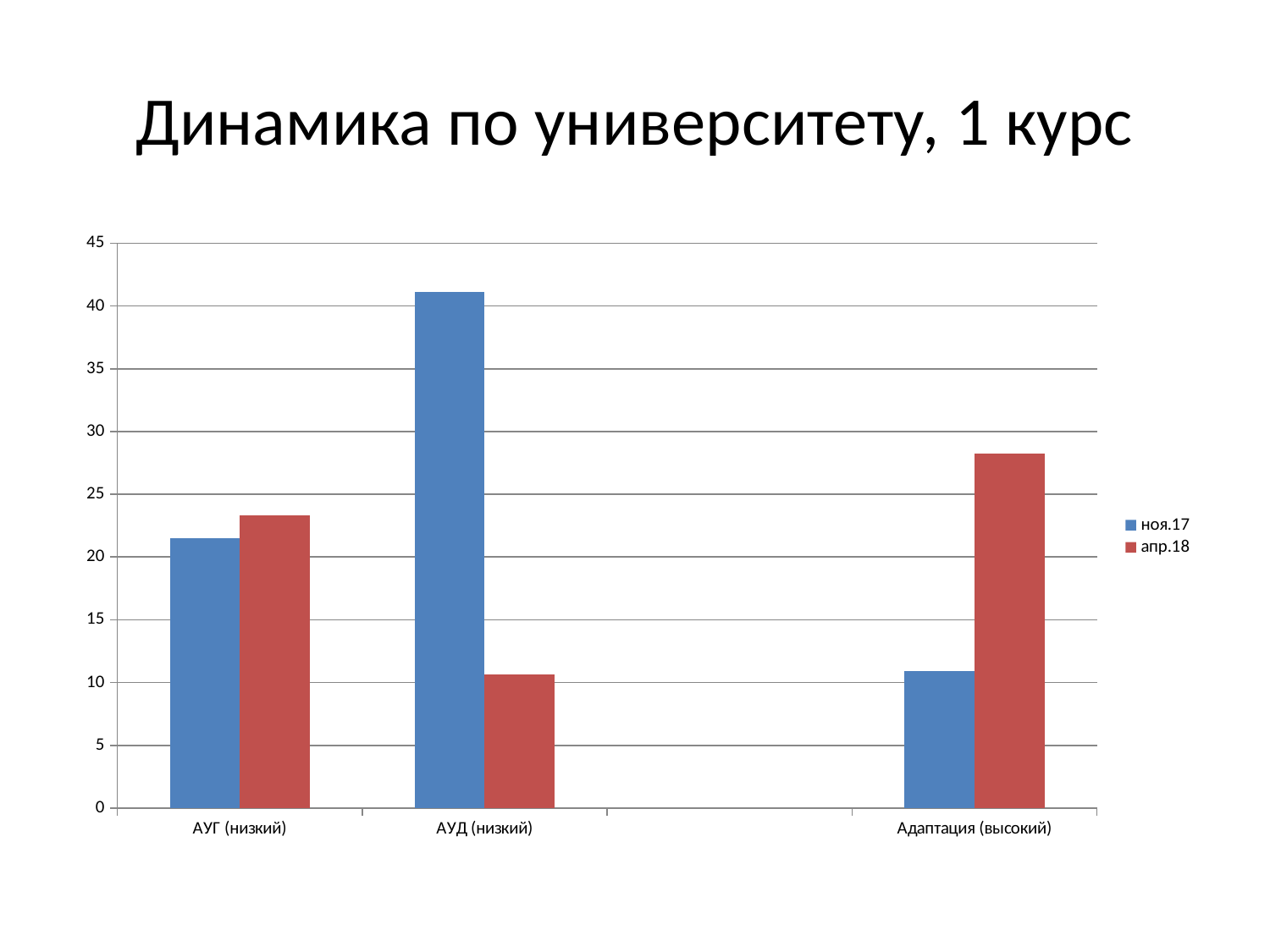
What are the two series named in the legend? ноя.17 and апр.18 Is the апр.18 value for Адаптация (высокий) greater or less than 25? greater Is the ноя.17 value for АУД (низкий) greater or less than 40? greater Is the ноя.17 value for Адаптация (высокий) greater or less than 15? less What is the title of the chart? Динамика по университету, 1 курс Which category and series has the highest bar in the chart? АУД (низкий), ноя.17 How many series does the legend list? 2 How many labeled categories have bars on the x axis? 3 For АУД (низкий), which series has the larger value, ноя.17 or апр.18? ноя.17 For Адаптация (высокий), which series has the larger value, ноя.17 or апр.18? апр.18 What type of chart is shown on the slide? Bar chart